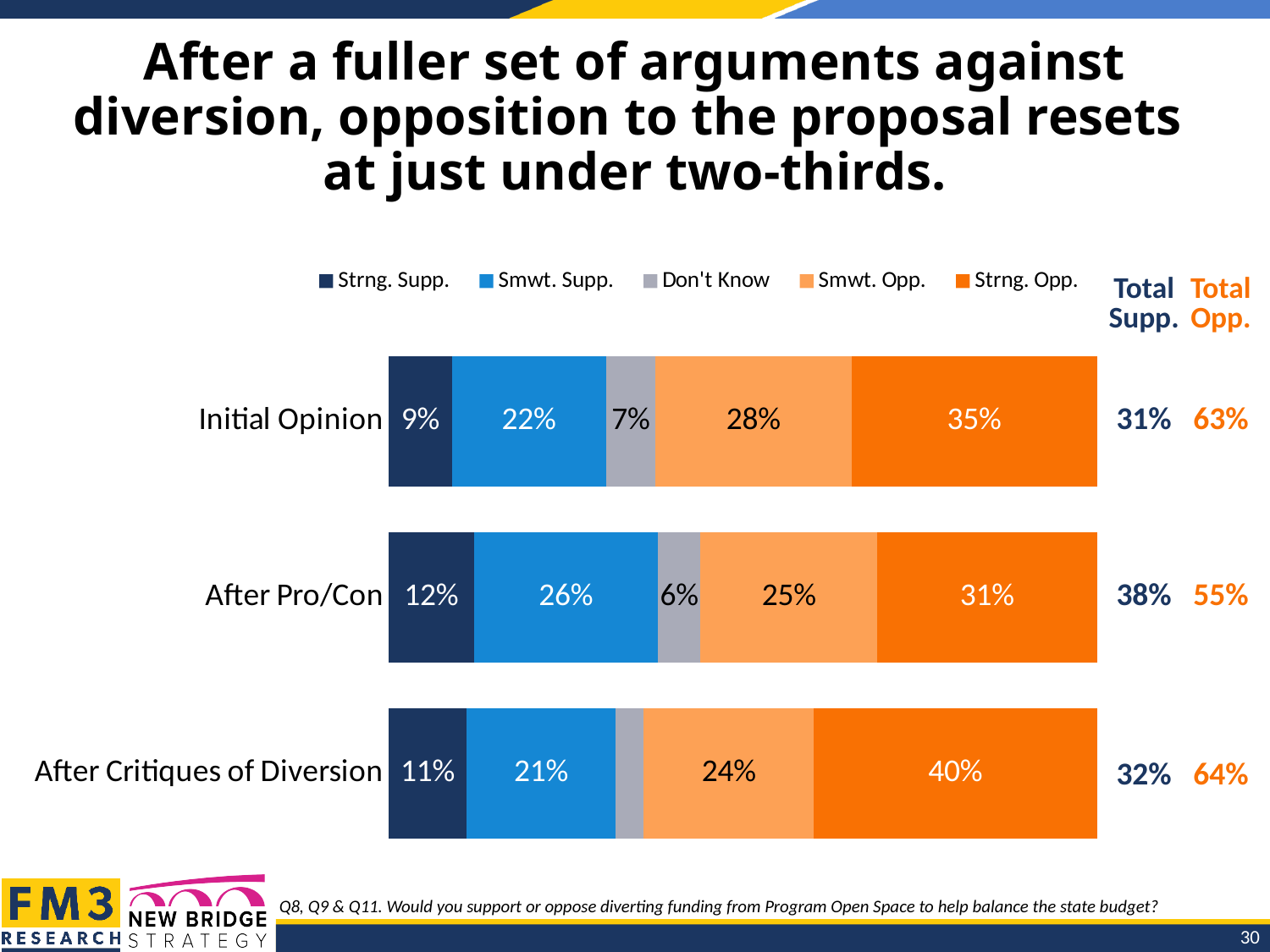
What is the difference between the Strng. Opp. values for After Critiques of Diversion and After Pro/Con? 9% What is the Strng. Opp. value for After Critiques of Diversion? 40% How many categories (bars) are plotted in the chart? 3 What is the Total Opp. shown for After Pro/Con? 55% Which is larger: the Smwt. Opp. value for Initial Opinion or for After Critiques of Diversion? Initial Opinion What is the Strng. Opp. value for Initial Opinion? 35% Which category has the lowest Strng. Supp. value? Initial Opinion What type of chart is shown on the slide? Stacked bar chart What is the Smwt. Supp. value for After Pro/Con? 26% What is the Don't Know value for Initial Opinion? 7% Which category has the highest Strng. Opp. value? After Critiques of Diversion How many series does the legend list? 5